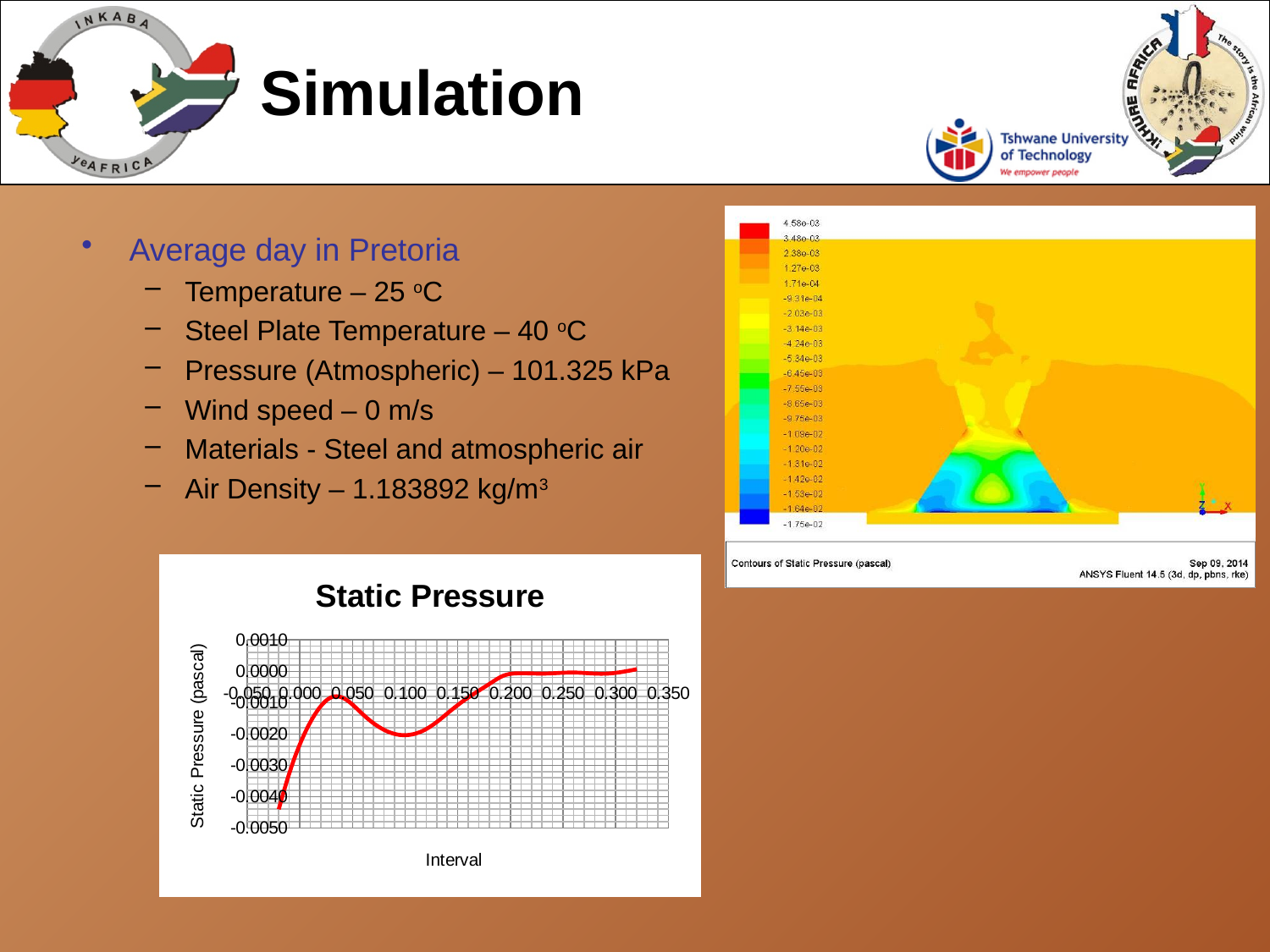
What kind of chart is the 'Static Pressure' chart? line chart On the 'Static Pressure' chart, is the value at the left end of the line (near interval -0.050) greater or less than -0.0030? less On the 'Static Pressure' chart, which is larger: the value at interval 0.100 or the value at interval 0.250? 0.250 On the 'Static Pressure' chart, is the value at interval 0.100 greater or less than -0.0010? less On the 'Static Pressure' chart, how many tick labels are shown on the x axis? 9 What is the label of the y axis on the 'Static Pressure' chart? Static Pressure (pascal) On the 'Static Pressure' chart, how many lines are plotted? 1 On the 'Static Pressure' chart, what is the lowest value shown on the y axis? -0.0050 What is the title of the chart at the bottom left of the slide? Static Pressure On the 'Static Pressure' chart, does the line overall rise or fall from the left end to the right end of the x axis? rise On the 'Static Pressure' chart, is the value at interval 0.250 greater or less than -0.0010? greater